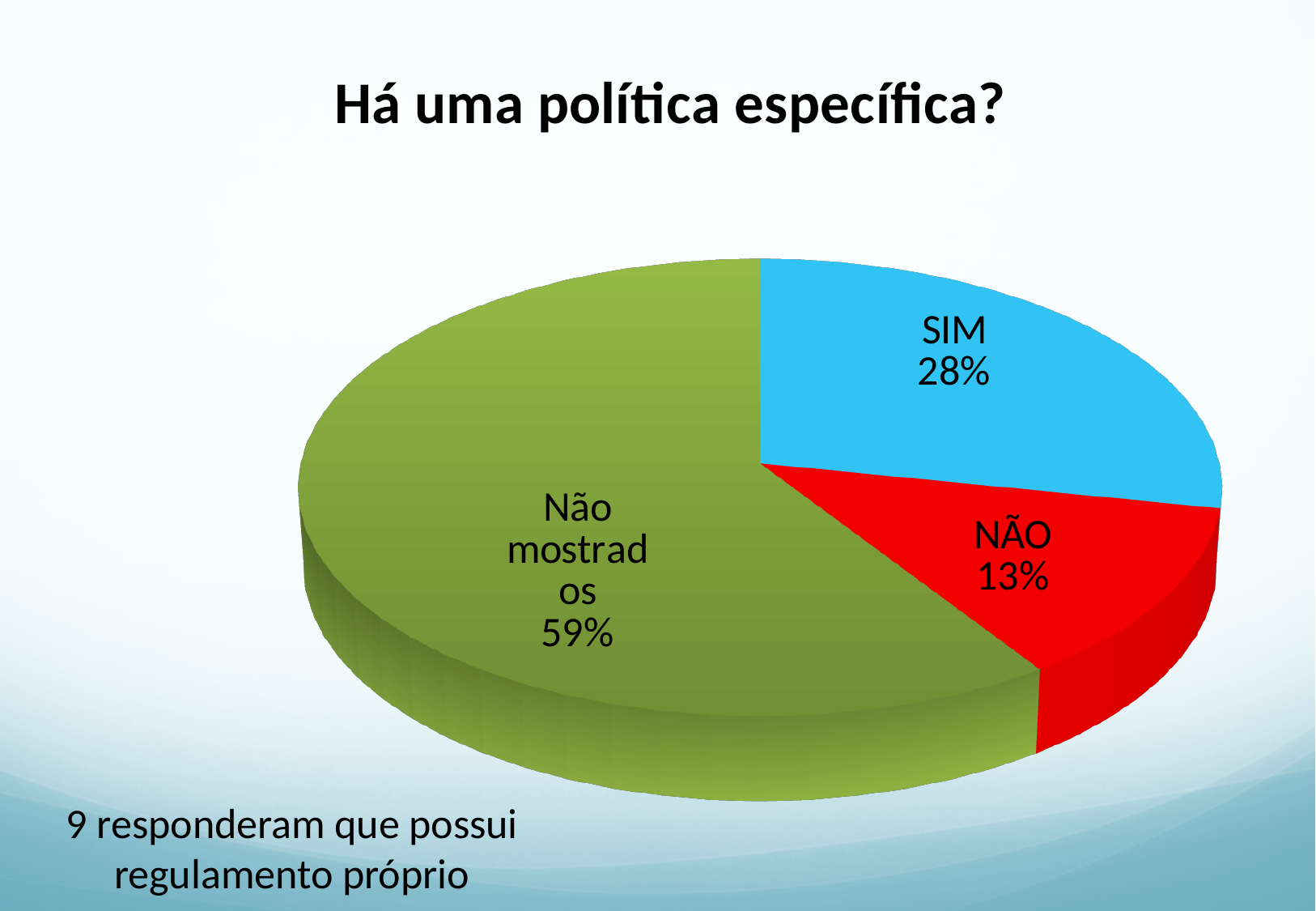
What percentage of the pie is labelled SIM? 28% How many slices does the pie chart have? 3 Which slice of the pie is the smallest? NÃO Which is larger, the SIM slice or the NÃO slice? SIM What is the difference in percentage points between the Não mostrados slice and the SIM slice? 31 What colour is the SIM slice? blue What type of chart is shown on the slide? pie chart What percentage of the pie is labelled NÃO? 13% What is the difference in percentage points between the SIM slice and the NÃO slice? 15 What percentage of the pie is labelled Não mostrados? 59% Which slice of the pie is the largest? Não mostrados What is the title of the chart? Há uma política específica?